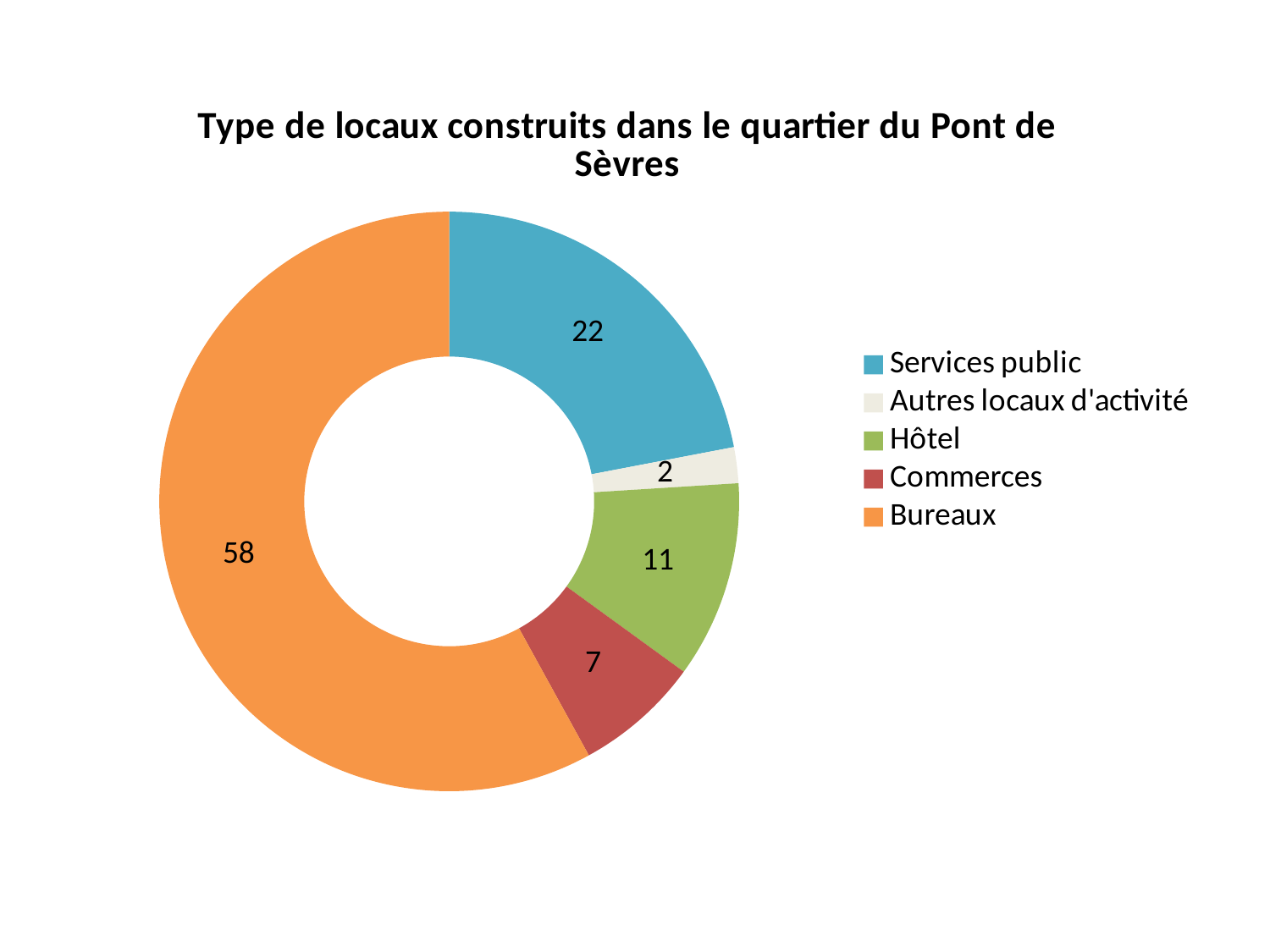
How many categories does the chart show? 5 What value is shown for Bureaux? 58 What value is shown for Hôtel? 11 What is the difference between the values for Bureaux and Services public? 36 What value is shown for Commerces? 7 Which category has the largest slice? Bureaux What kind of chart is shown on the slide? Doughnut (pie) chart What is the title of the chart? Type de locaux construits dans le quartier du Pont de Sèvres Which category has the smallest slice? Autres locaux d'activité What value is shown for Services public? 22 What is the total of all the values shown on the chart? 100 Which is larger, the value for Hôtel or the value for Commerces? Hôtel